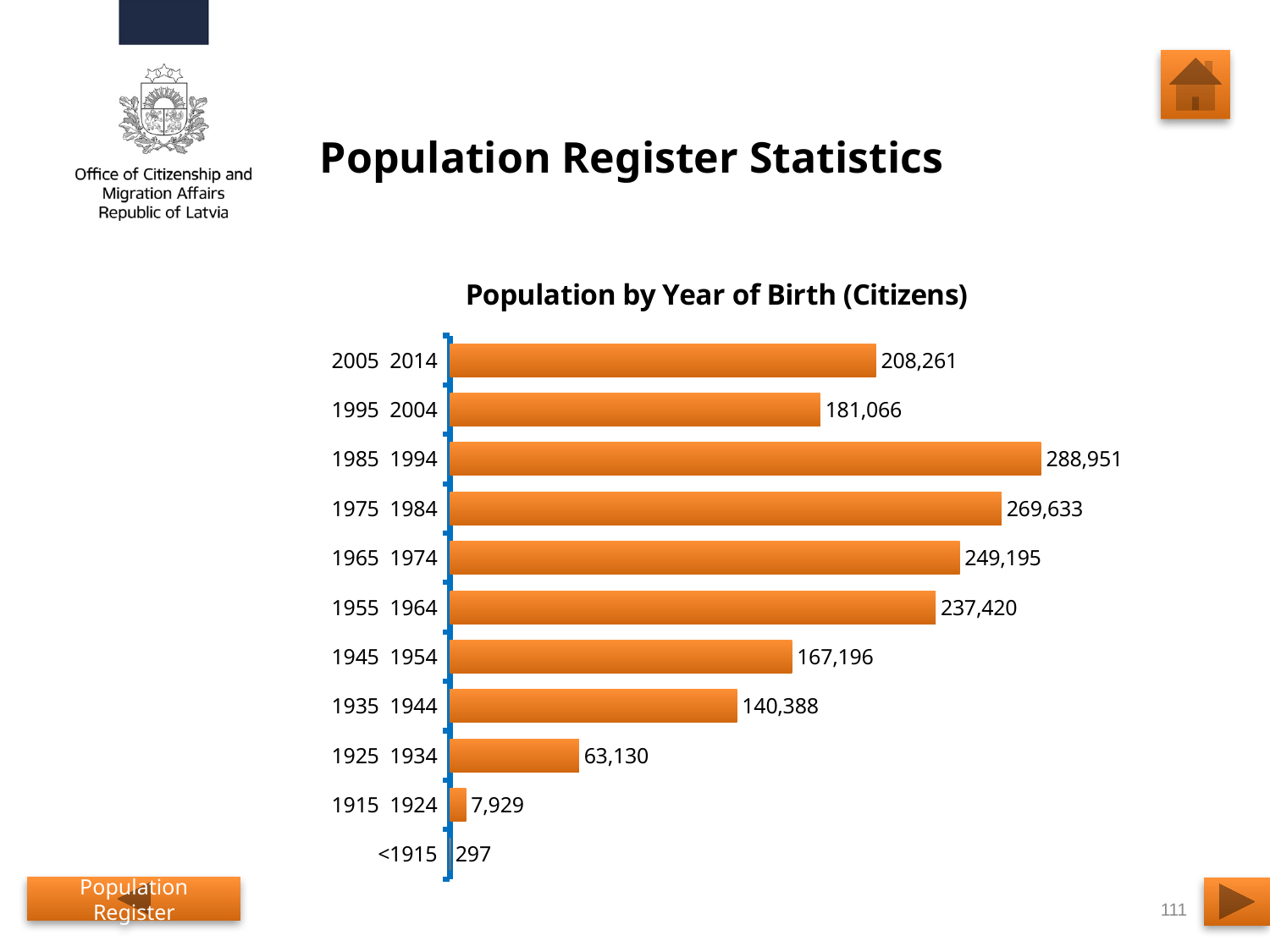
What colour are the bars in the chart? Orange Which year-of-birth category has the lowest value? <1915 What kind of chart is shown on the slide? Bar chart What is the value for the 1925 1934 category? 63,130 What is the difference between the values for 2005 2014 and 1995 2004? 27,195 What is the difference between the values for 1935 1944 and 1925 1934? 77,258 How many year-of-birth categories are shown in the chart? 11 What is the value for the <1915 category? 297 Which year-of-birth category has the highest value? 1985 1994 What is the title of the chart? Population by Year of Birth (Citizens) Which is larger, the value for 1965 1974 or the value for 1955 1964? 1965 1974